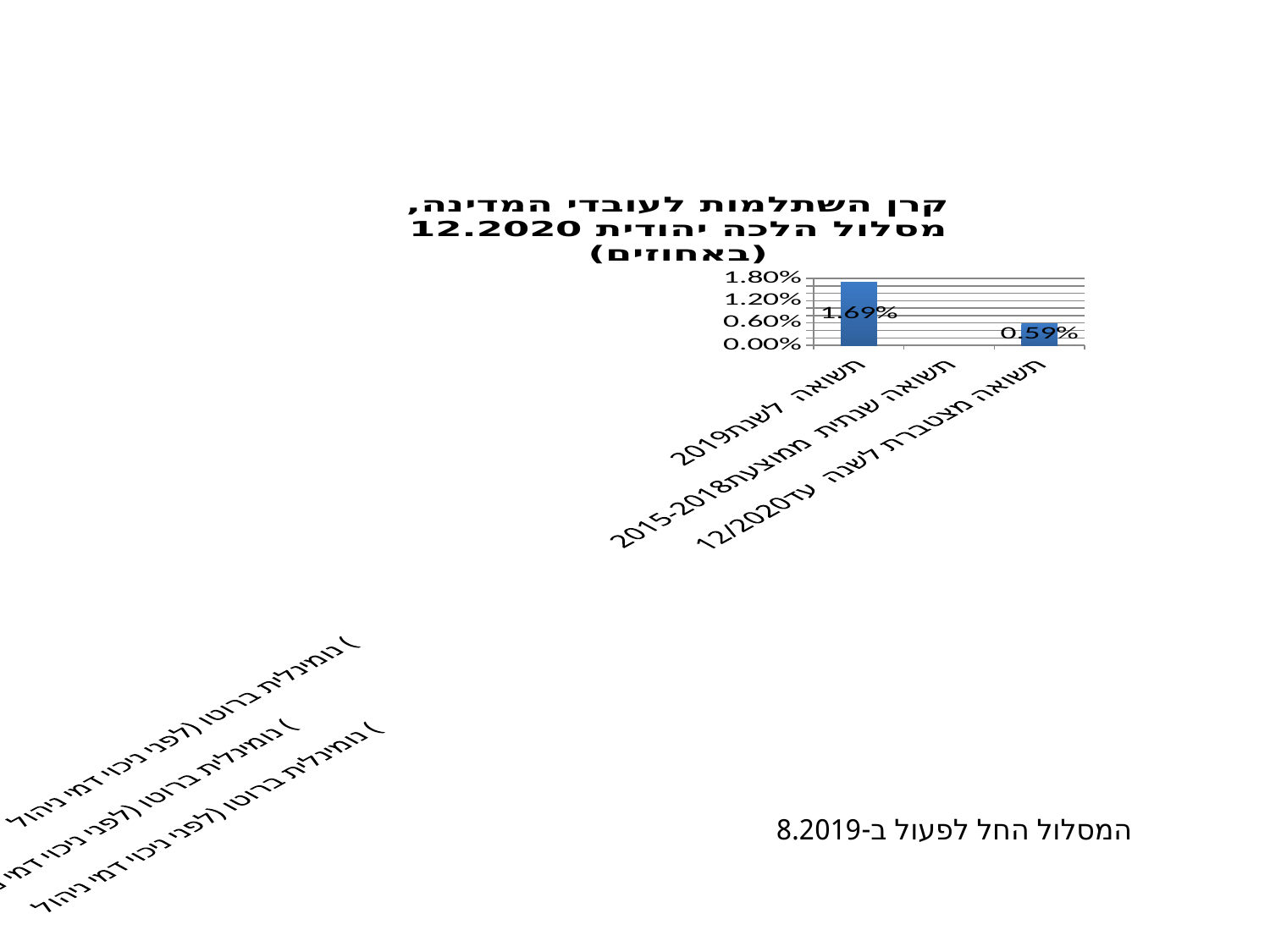
What kind of chart is shown on the slide? bar chart Which is larger: the value for תשואה לשנת 2019 or the value for תשואה מצטברת לשנה עד 12/2020? תשואה לשנת 2019 How many categories are shown on the x axis of the chart? 3 What is the value for תשואה לשנת 2019? 1.69% What is the value for תשואה מצטברת לשנה עד 12/2020? 0.59% What is the difference between the value for תשואה לשנת 2019 and the value for תשואה מצטברת לשנה עד 12/2020? 1.10% Is the value for תשואה מצטברת לשנה עד 12/2020 greater or less than 1.20%? less What is the title of the chart? קרן השתלמות לעובדי המדינה, מסלול הלכה יהודית 12.2020 (באחוזים) Is the value for תשואה לשנת 2019 greater or less than 1.20%? greater Which category on the x axis has no bar plotted? תשואה שנתית ממוצעת 2015-2018 Which category has the highest value? תשואה לשנת 2019